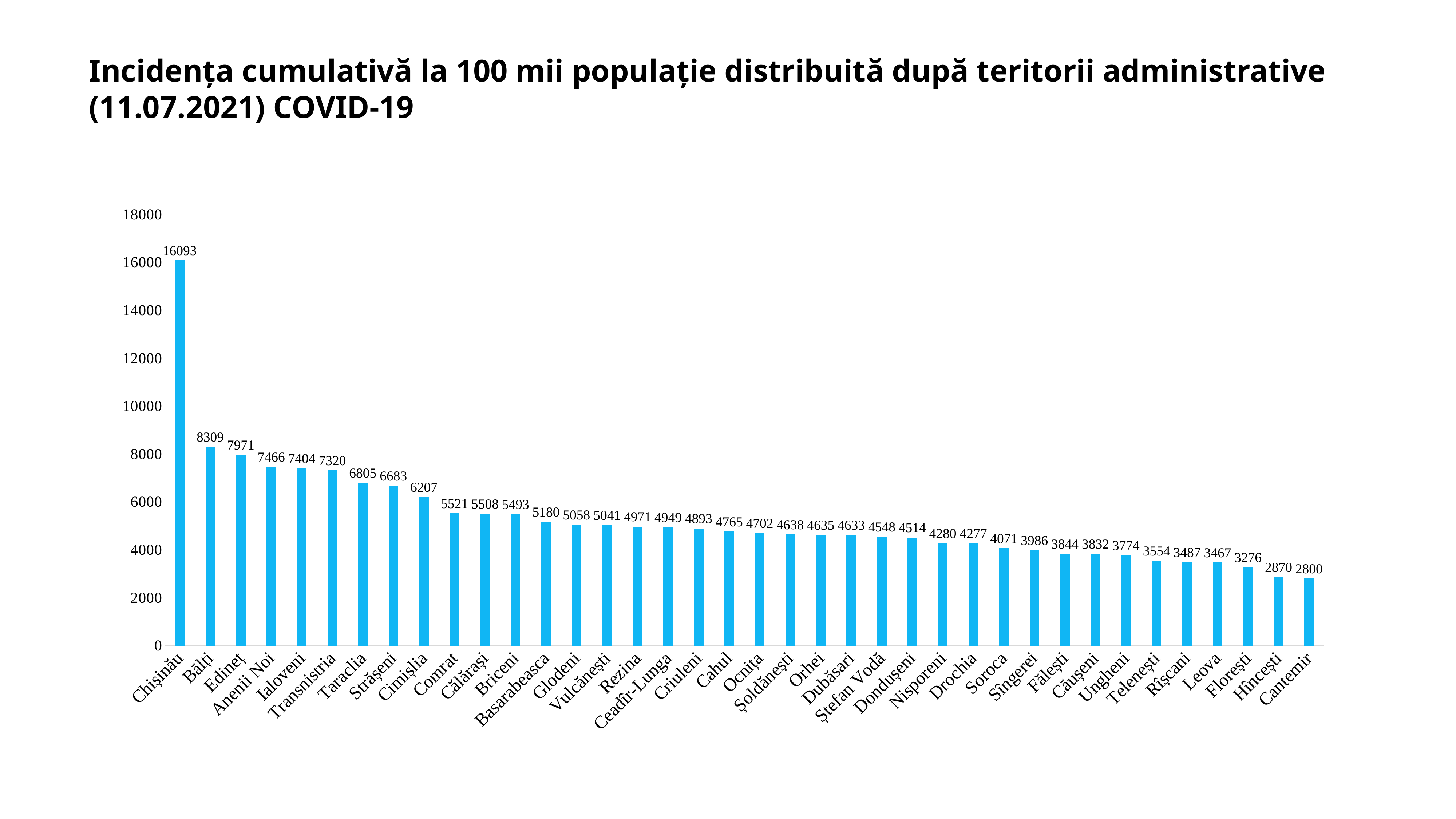
Which has a larger value, Edineț or Taraclia? Edineț How many territories are shown on the chart? 38 What is the value for Soroca? 4071 What is the value for Transnistria? 7320 What is the difference between the values for Hîncești and Cantemir? 70 Do the values rise or fall from left to right along the x axis? Fall What kind of chart is this? Bar chart What is the difference between the values for Chișinău and Bălți? 7784 What is the value for Cahul? 4765 Which territory has the lowest value? Cantemir Which territory has the highest value? Chișinău What is the value for Chișinău? 16093